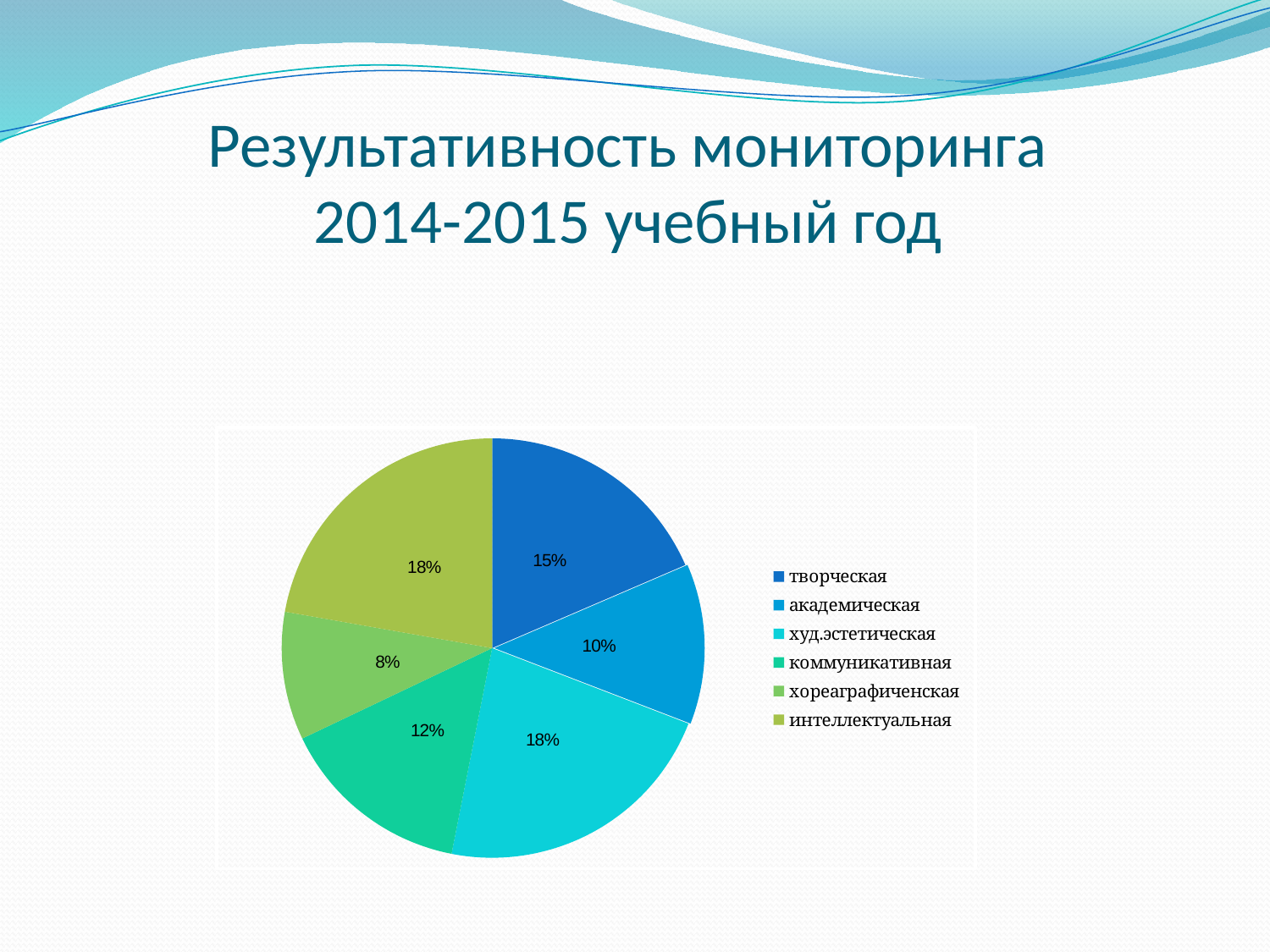
How many categories does the legend list? 6 Which is larger, the slice for творческая or the slice for академическая? творческая What is the value shown for интеллектуальная? 18% What is the value shown for хореаграфиченская? 8% What is the value shown for академическая? 10% What is the difference between the values for творческая and хореаграфиченская? 7% What is the value shown for коммуникативная? 12% What is the title of the slide containing the chart? Результативность мониторинга 2014-2015 учебный год What is the difference between the values for худ.эстетическая and коммуникативная? 6% Which category has the smallest slice of the pie? хореаграфиченская What is the value shown for творческая? 15% What type of chart is shown on the slide? pie chart